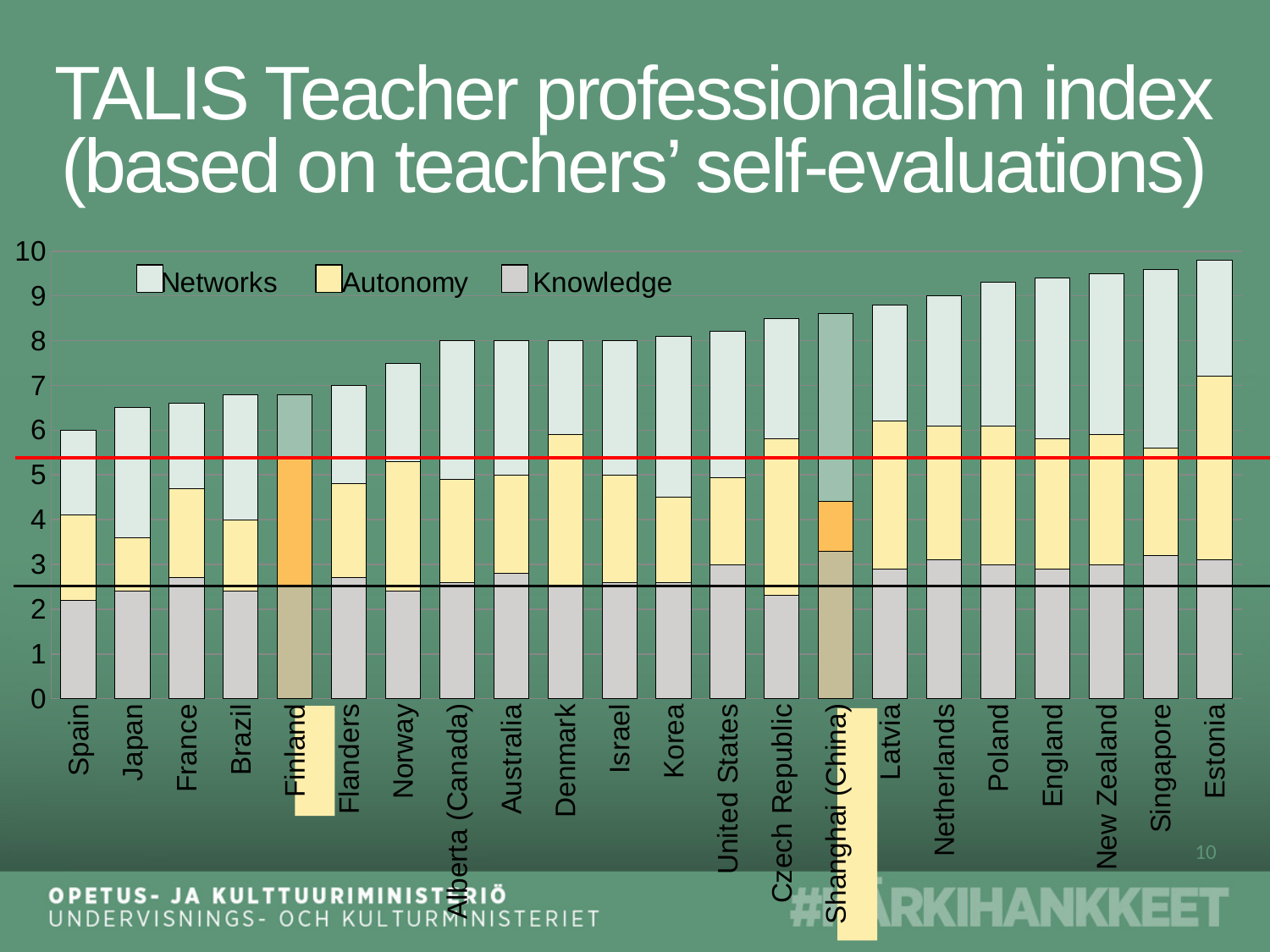
Do the total bar heights rise or fall from left to right along the x axis? rise Is the total bar for Finland greater or less than 8? less What kind of chart is shown on the slide? Stacked bar chart Which has the larger total bar, Singapore or Japan? Singapore Which series are listed in the legend? Networks, Autonomy, Knowledge Is the total bar for Estonia greater or less than 9? greater Which country has the highest total bar? Estonia Which country has the lowest total bar? Spain How many countries or regions are shown on the x axis? 22 How many series does the legend list? 3 Is the total bar for Spain greater or less than 7? less